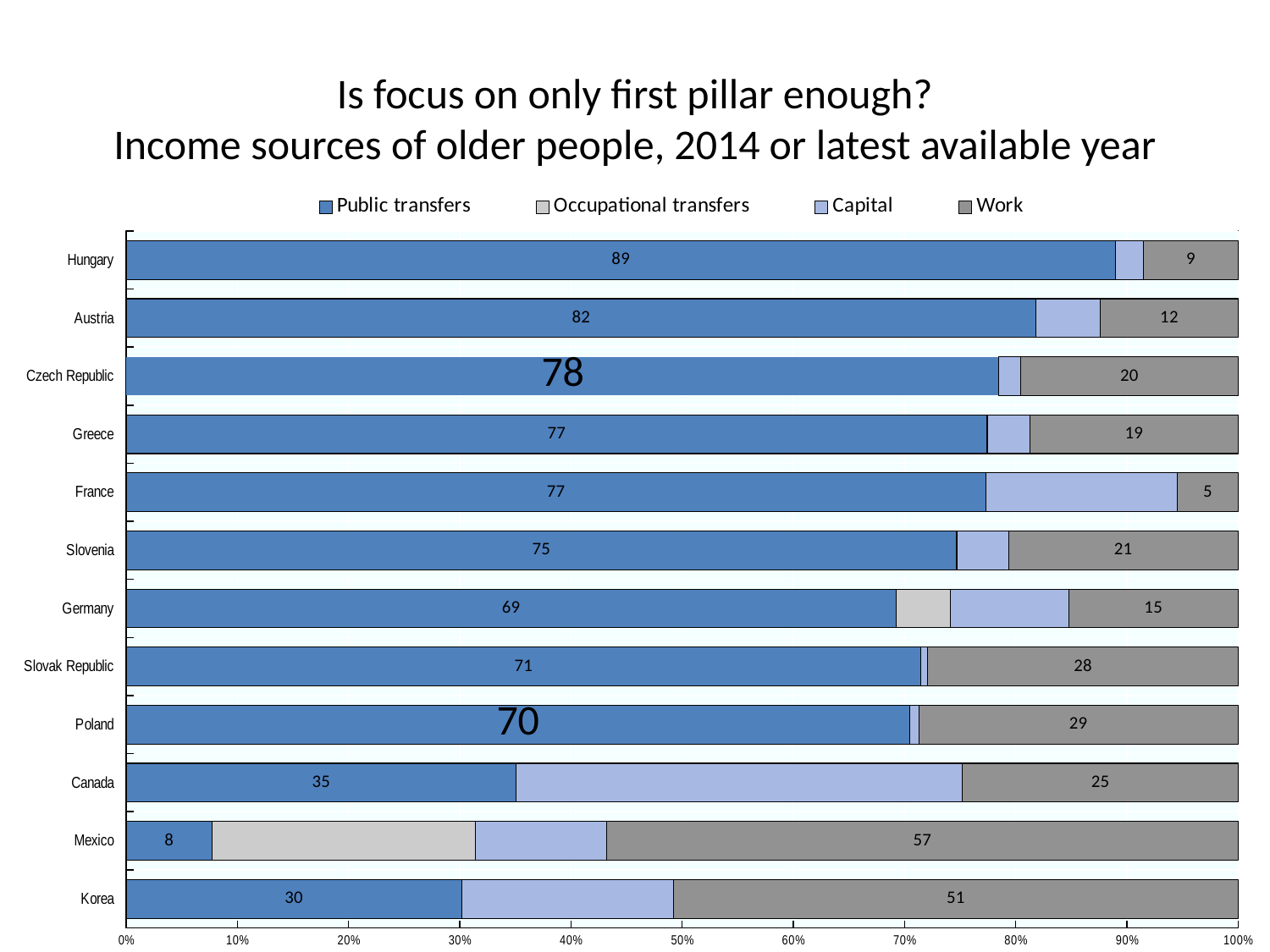
Which country has the highest Public transfers value? Hungary How many series does the legend list? 4 What is the Work value for France? 5 Is the Capital value for Canada greater or less than 30%? greater What kind of chart is shown on the slide? Stacked bar chart Which has a larger Work value, Korea or Canada? Korea How many countries are shown in the chart? 12 What is the Public transfers value for Hungary? 89 What is the difference between the Public transfers values for Hungary and Mexico? 81 What is the Work value for Mexico? 57 Which country has the lowest Public transfers value? Mexico Which country has the highest Work value? Mexico